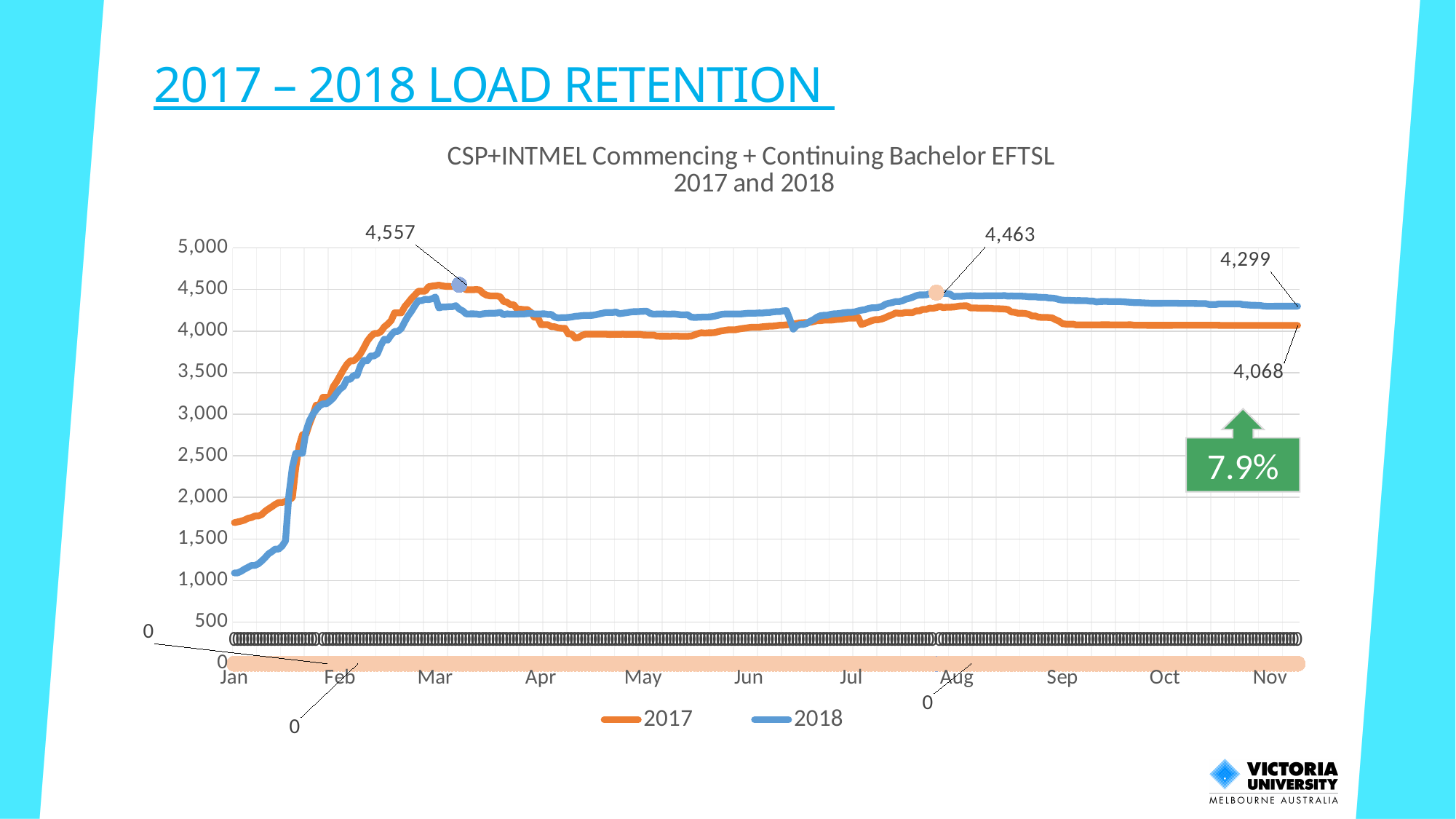
What is the difference between the labelled November values of 2018 (4,299) and 2017 (4,068)? 231 What is the labelled value of the 2018 series at the end of the chart in November? 4,299 Is the 2017 value at the start of January greater or less than 1,500? greater How many series does the legend list? 2 What percentage is shown in the green box with the upward arrow? 7.9% Do the values of both series rise or fall between January and March? rise What is the labelled value marked near the end of July / start of August? 4,463 Which series is higher at the end of the chart in November, 2017 or 2018? 2018 What is the labelled peak value reached in early March? 4,557 What is the labelled value of the 2017 series at the end of the chart in November? 4,068 Is the 2018 value at the start of January greater or less than 1,500? less What type of chart is shown on the slide? line chart